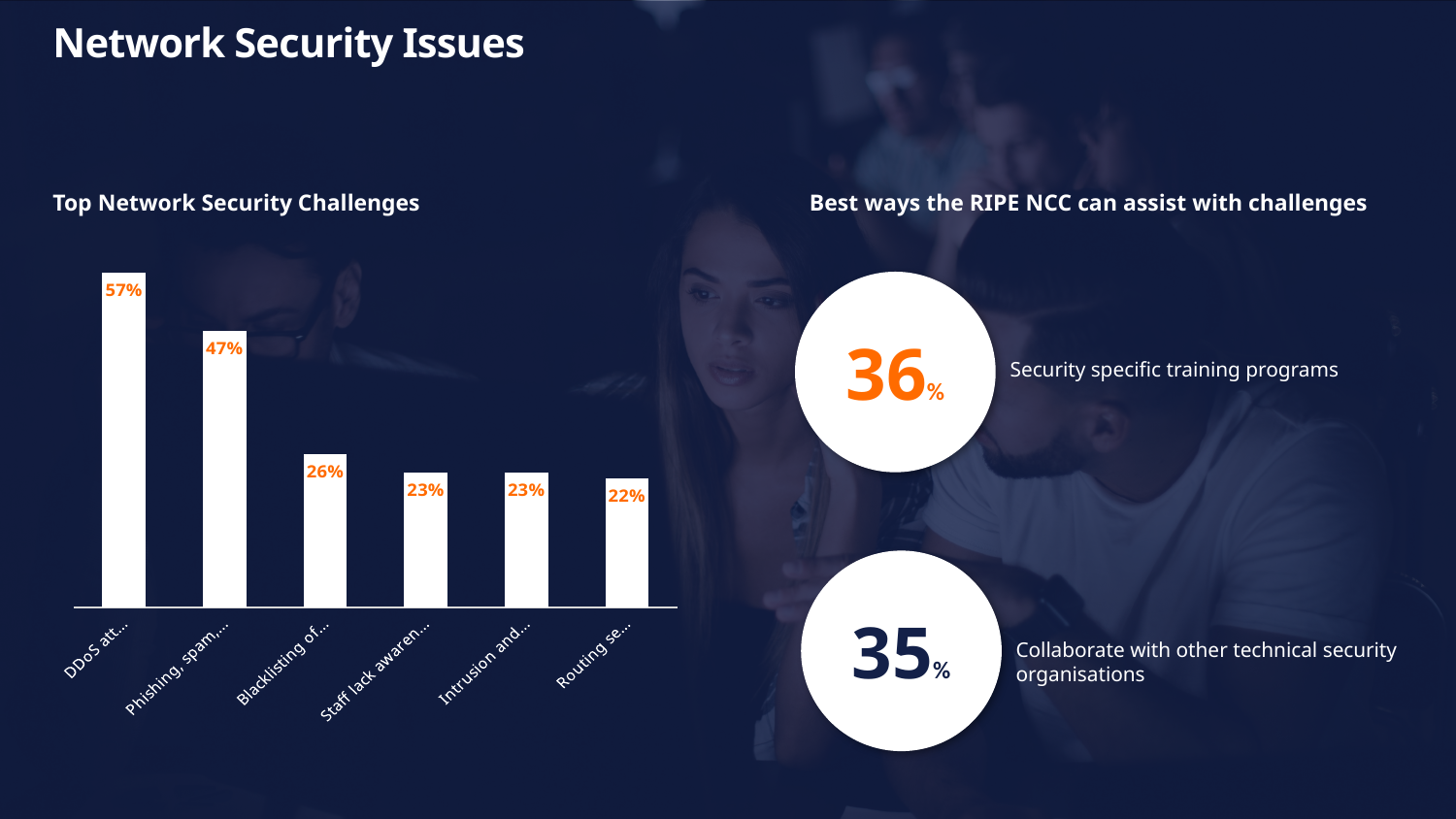
In the "Top Network Security Challenges" chart, what is the value for the DDoS category? 57% Which category has the highest value in the "Top Network Security Challenges" chart? DDoS att... What colour are the data labels in the "Top Network Security Challenges" chart? orange In the "Top Network Security Challenges" chart, what is the value for the Phishing, spam category? 47% In the "Top Network Security Challenges" chart, what is the value for the Blacklisting category? 26% Which category has the lowest value in the "Top Network Security Challenges" chart? Routing se... In the "Top Network Security Challenges" chart, what is the value for the Routing category (the last bar)? 22% In the "Top Network Security Challenges" chart, do the values rise or fall from left to right? fall How many bars does the "Top Network Security Challenges" chart have? 6 In the "Top Network Security Challenges" chart, which is larger: the Blacklisting value or the Intrusion value? Blacklisting of... What kind of chart is shown under "Top Network Security Challenges"? bar chart In the "Top Network Security Challenges" chart, what is the difference between the DDoS value and the Phishing, spam value? 10%